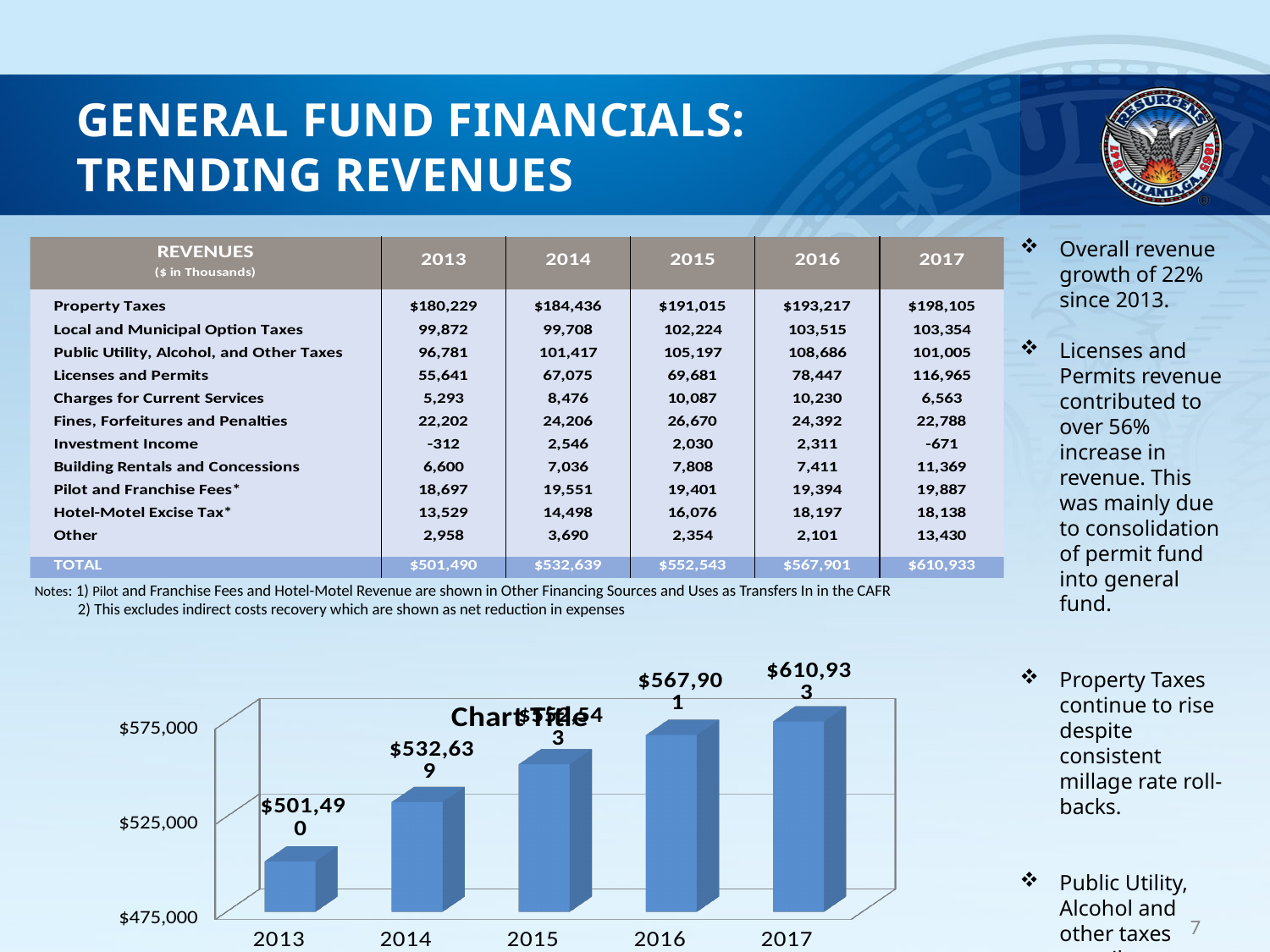
What is the value shown for 2014 in the bar chart? $532,639 Do the values in the bar chart rise or fall from 2013 to 2017? Rise What is the value shown for 2016 in the bar chart? $567,901 What is the difference between the 2017 and 2013 values in the bar chart? $109,443 Which year has the highest value in the bar chart? 2017 What type of chart is shown at the bottom of the slide? Bar chart What is the value shown for 2017 in the bar chart? $610,933 How many years are plotted on the x axis of the bar chart? 5 Which is larger in the bar chart, the value for 2014 or the value for 2016? 2016 Which year has the lowest value in the bar chart? 2013 Is the value for 2017 in the bar chart greater or less than $575,000? greater What is the value shown for 2013 in the bar chart? $501,490